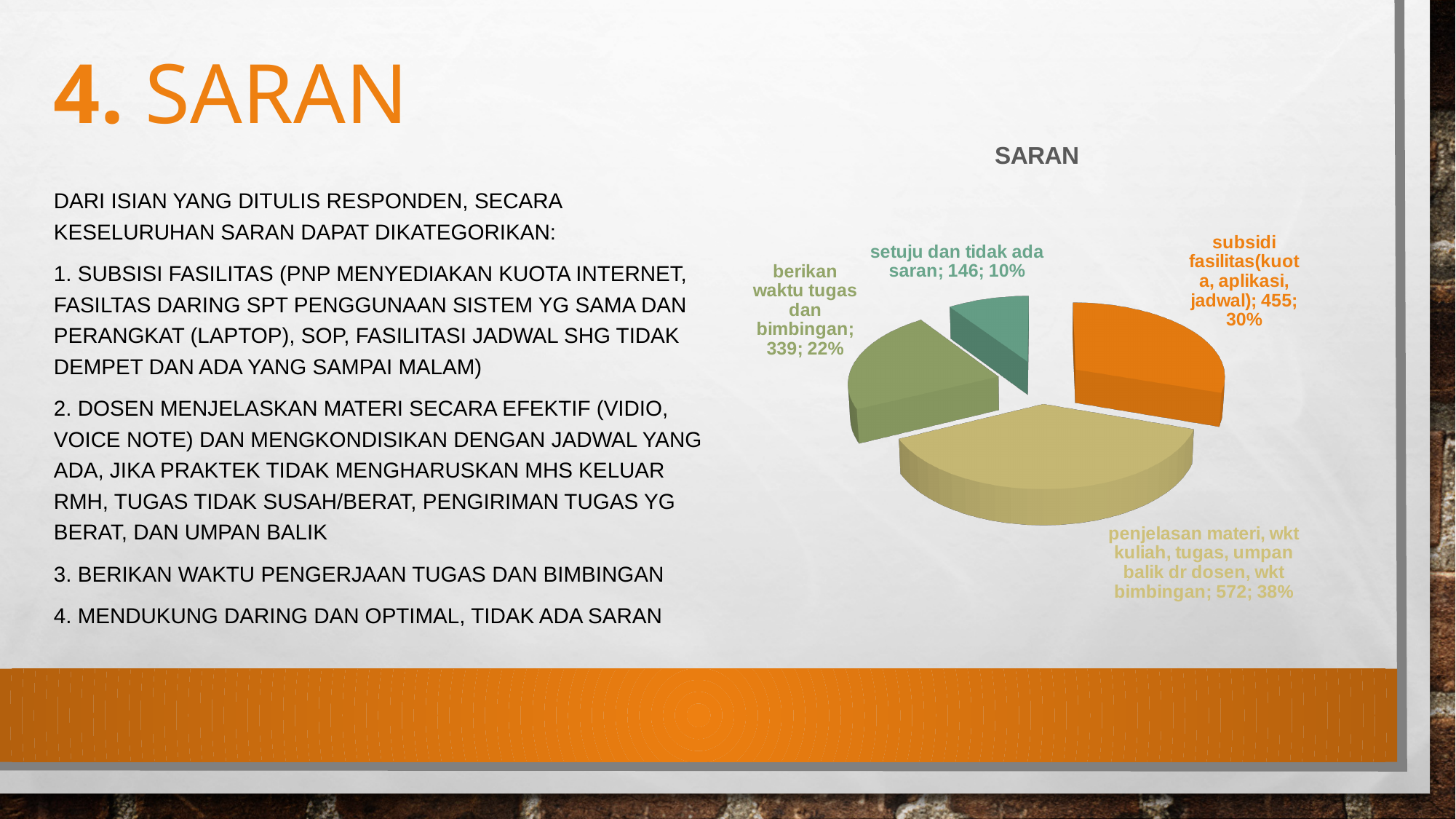
What is the difference between the values for 'subsidi fasilitas(kuota, aplikasi, jadwal)' and 'berikan waktu tugas dan bimbingan'? 116 What percentage share does the slice 'penjelasan materi, wkt kuliah, tugas, umpan balik dr dosen, wkt bimbingan' have? 38% Which is larger: the value for 'subsidi fasilitas(kuota, aplikasi, jadwal)' or the value for 'setuju dan tidak ada saran'? subsidi fasilitas(kuota, aplikasi, jadwal) What is the value for the slice 'subsidi fasilitas(kuota, aplikasi, jadwal)'? 455 What is the value for the slice 'setuju dan tidak ada saran'? 146 What kind of chart is shown on the slide? pie chart What is the title of the chart? SARAN Which slice has the smallest value? setuju dan tidak ada saran How many slices does the pie chart have? 4 What percentage share does the slice 'berikan waktu tugas dan bimbingan' have? 22% What is the value for the slice 'berikan waktu tugas dan bimbingan'? 339 Which slice has the largest value? penjelasan materi, wkt kuliah, tugas, umpan balik dr dosen, wkt bimbingan